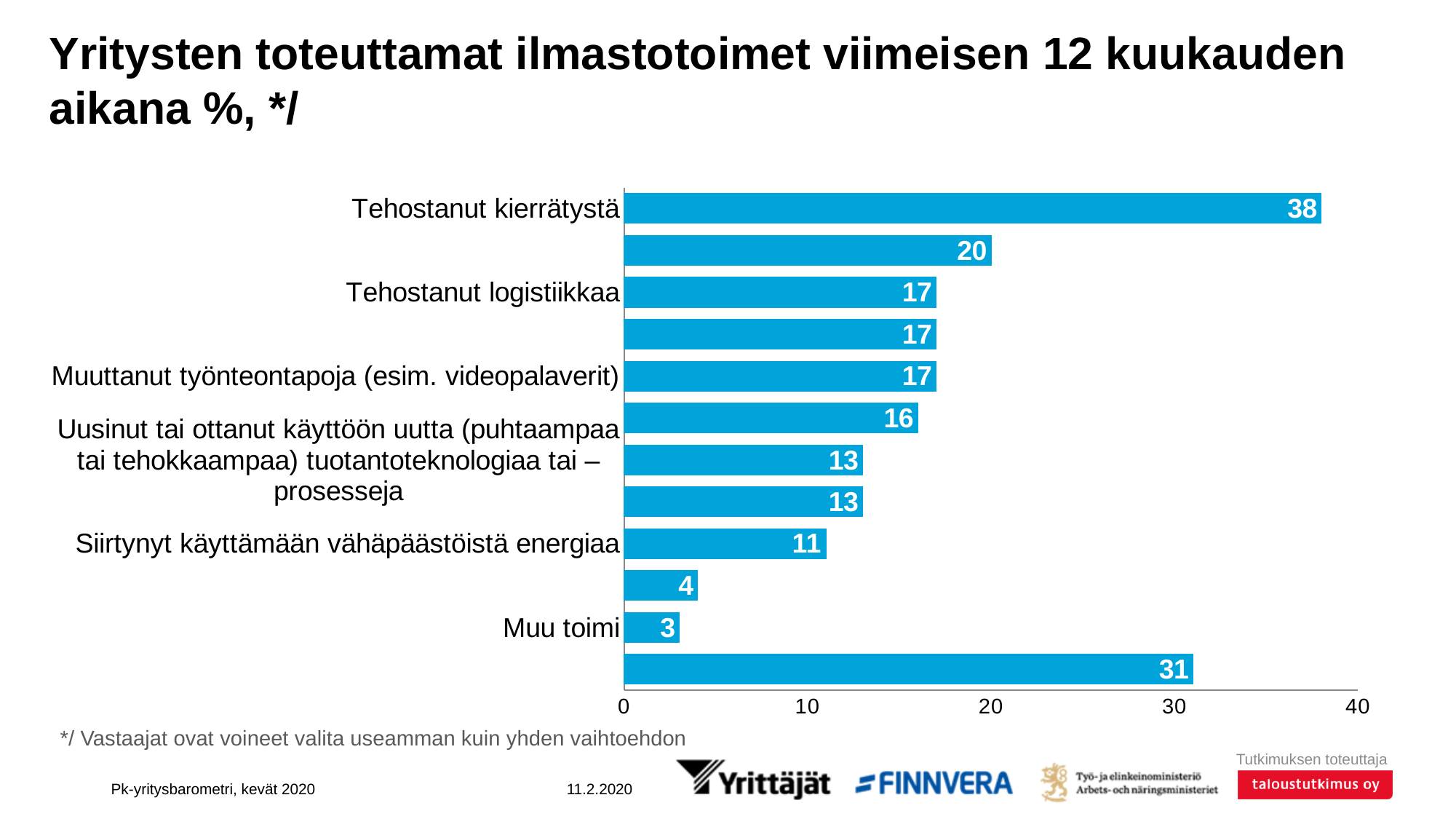
What kind of chart is shown on the slide? bar chart What is the value for Muuttanut työnteontapoja (esim. videopalaverit)? 17 What is the value for Siirtynyt käyttämään vähäpäästöistä energiaa? 11 What is the value for Tehostanut logistiikkaa? 17 What is the value for Muu toimi? 3 How many bars are plotted in the chart? 12 What is the value for Tehostanut kierrätystä? 38 Which category has the lowest value? Muu toimi Which category has the highest value? Tehostanut kierrätystä Is the value for Tehostanut kierrätystä greater or less than 30? greater What is the difference between the values for Tehostanut kierrätystä and Tehostanut logistiikkaa? 21 Which is larger, the value for Tehostanut logistiikkaa or the value for Siirtynyt käyttämään vähäpäästöistä energiaa? Tehostanut logistiikkaa